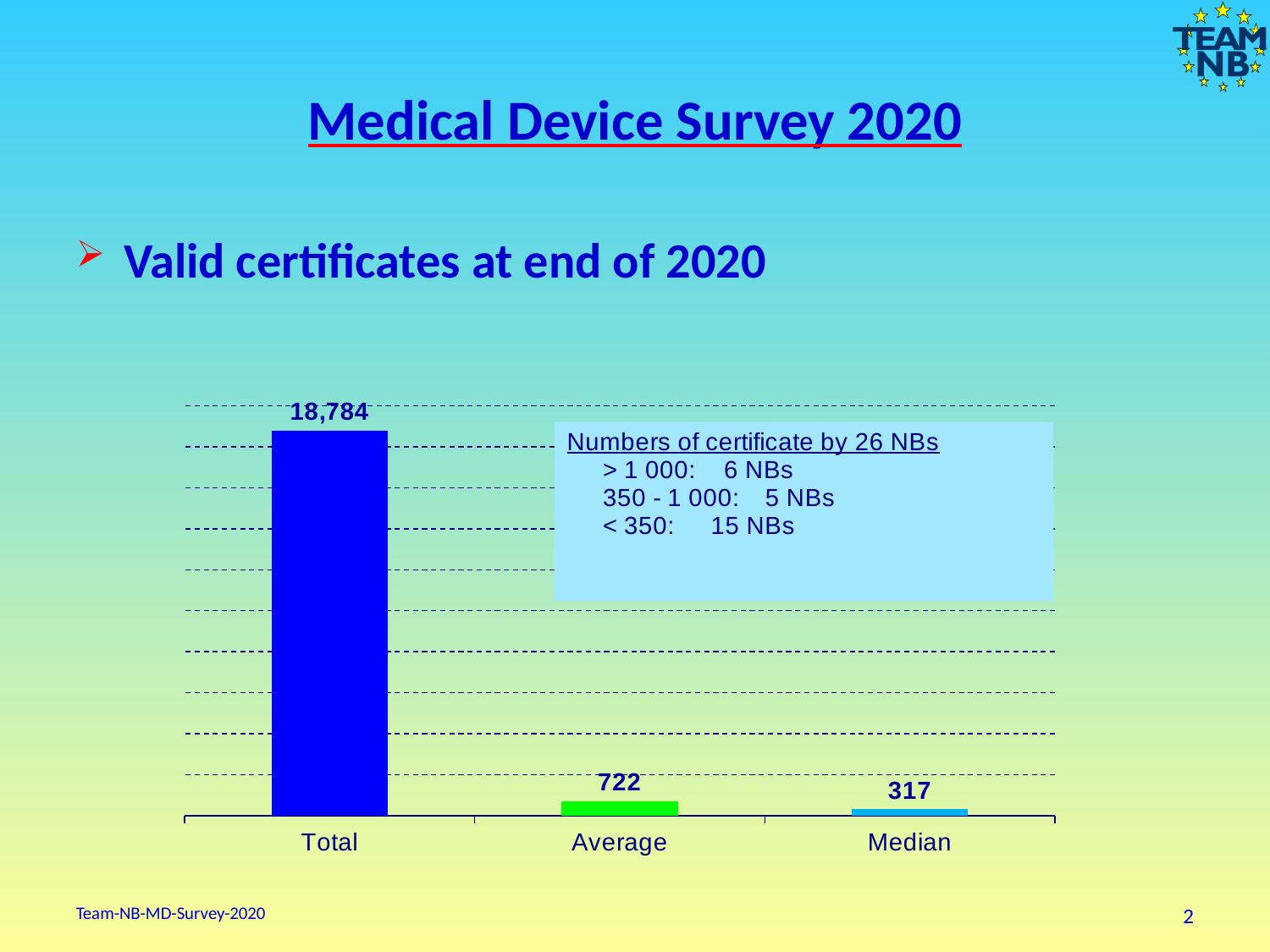
What is the difference between the Average and Median values? 405 What is the value of the Average bar? 722 Which is larger, the Average or the Median? Average How many categories are shown on the x axis? 3 Which category has the highest value? Total What is the value of the Total bar? 18,784 Which category has the lowest value? Median What kind of chart is shown on the slide? Bar chart What is the value of the Median bar? 317 What colour is the Total bar? Blue What is the difference between the Total and Average values? 18,062 Do the values rise or fall from left to right along the x axis? Fall